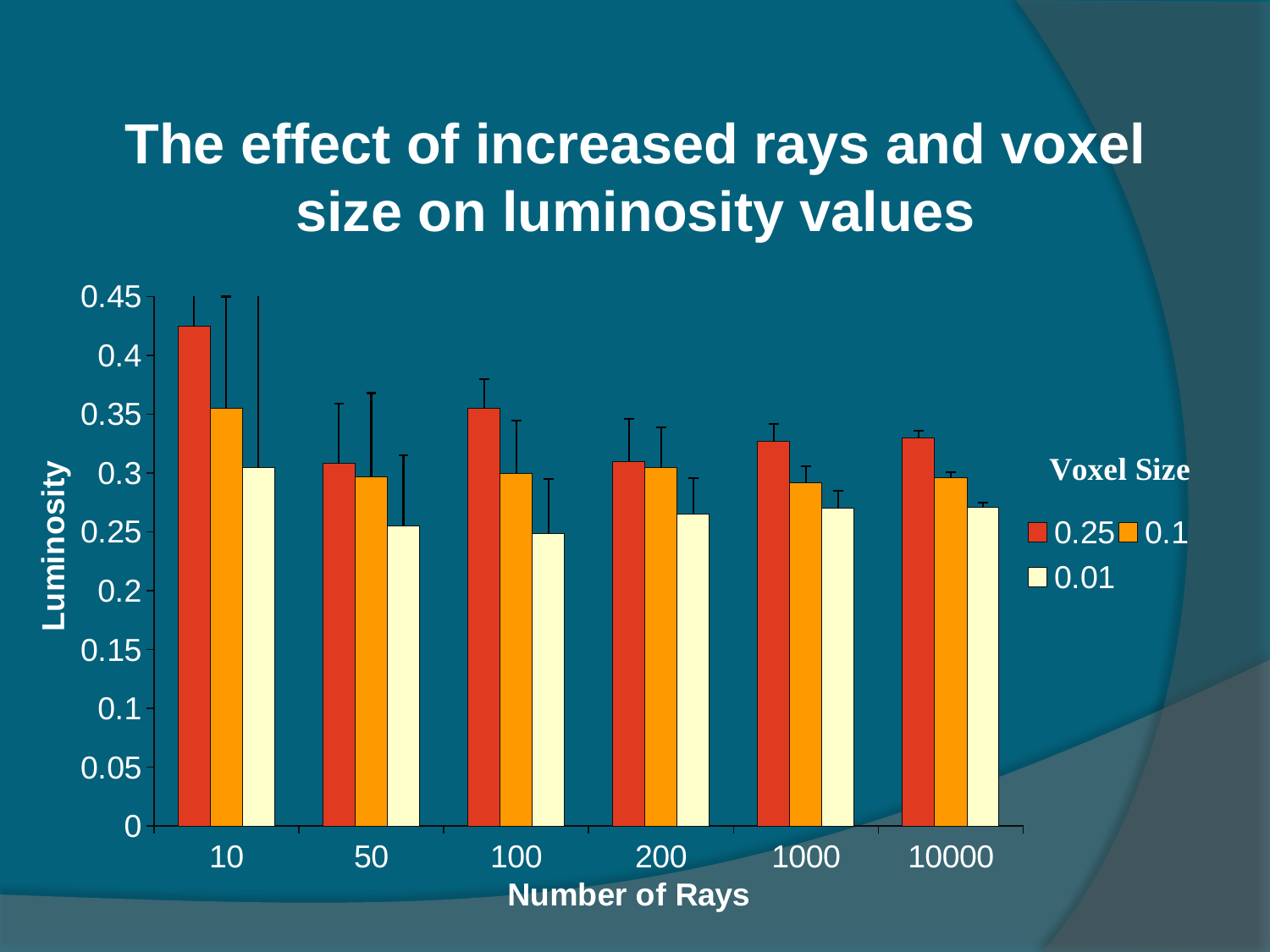
What is the label of the x axis? Number of Rays At 100 rays, which has the higher luminosity: voxel size 0.25 or voxel size 0.1? 0.25 Is the luminosity for voxel size 0.25 at 10 rays greater or less than 0.4? greater What kind of chart is shown on the slide? bar chart At 10 rays, which voxel size has the lowest luminosity? 0.01 How many Number of Rays categories are shown on the x axis? 6 How many series does the legend list? 3 What is the title of the legend? Voxel Size Which bar is the highest in the whole chart? Voxel size 0.25 at 10 rays Is the luminosity for voxel size 0.25 at 1000 rays greater or less than 0.3? greater For voxel size 0.25, which has the higher luminosity: 10 rays or 50 rays? 10 rays Is the luminosity for voxel size 0.01 at 100 rays greater or less than 0.3? less